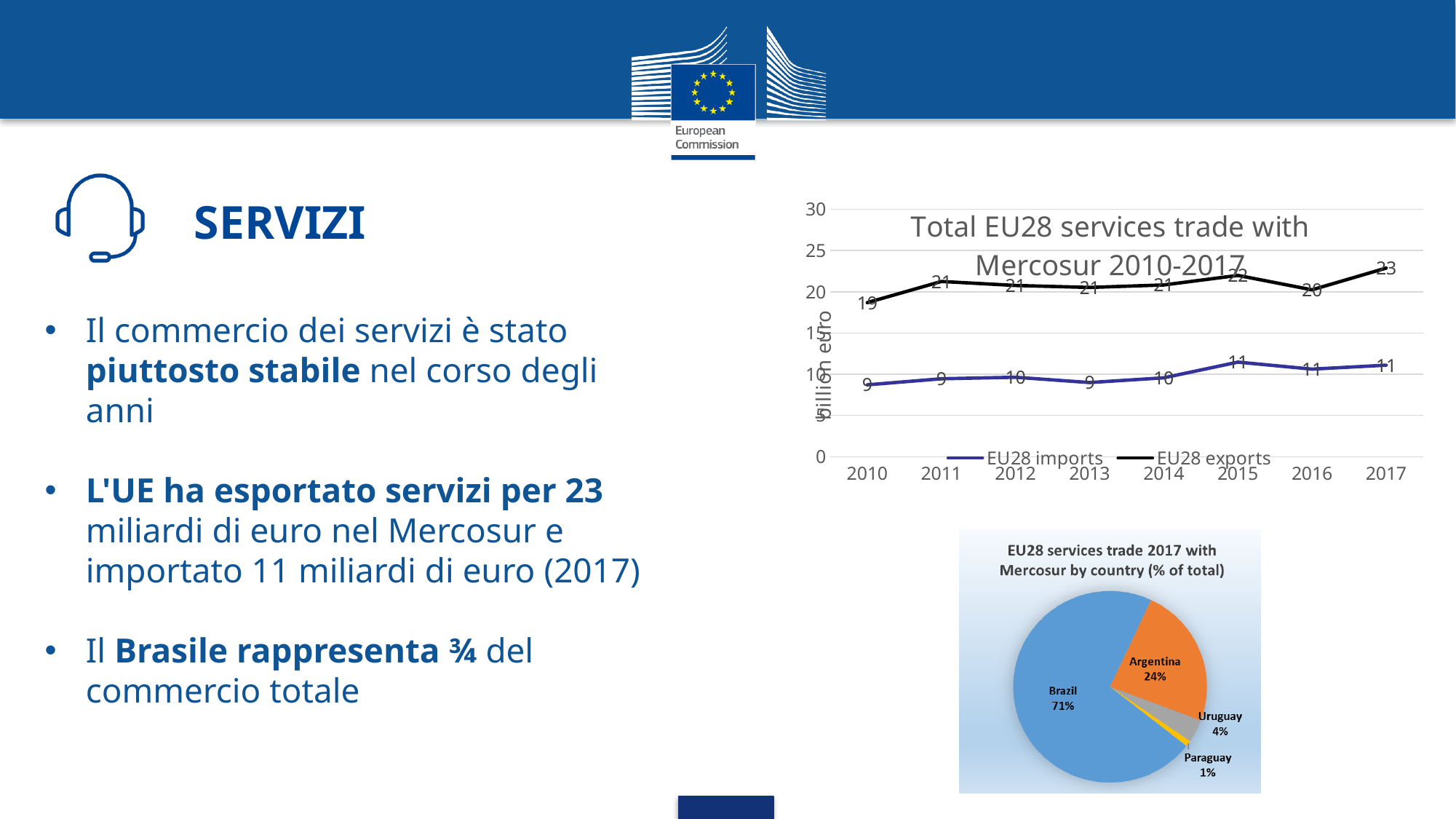
How many series does the legend of the line chart 'Total EU28 services trade with Mercosur 2010-2017' list? 2 In the line chart 'Total EU28 services trade with Mercosur 2010-2017', what is the value of EU28 imports in 2010? 9 In the pie chart 'EU28 services trade 2017 with Mercosur by country (% of total)', which country has the smallest share? Paraguay In the line chart 'Total EU28 services trade with Mercosur 2010-2017', which series is larger in 2014, EU28 imports or EU28 exports? EU28 exports In the pie chart 'EU28 services trade 2017 with Mercosur by country (% of total)', what share does Argentina have? 24% What kind of chart is 'EU28 services trade 2017 with Mercosur by country (% of total)'? pie chart In the line chart 'Total EU28 services trade with Mercosur 2010-2017', what is the difference between EU28 exports and EU28 imports in 2017? 12 In the line chart 'Total EU28 services trade with Mercosur 2010-2017', in which year are EU28 exports highest? 2017 How many years are shown on the x axis of the line chart 'Total EU28 services trade with Mercosur 2010-2017'? 8 In the line chart 'Total EU28 services trade with Mercosur 2010-2017', in which year are EU28 exports lowest? 2010 What is the label of the y axis of the line chart 'Total EU28 services trade with Mercosur 2010-2017'? billion euro In the line chart 'Total EU28 services trade with Mercosur 2010-2017', what is the value of EU28 exports in 2017? 23